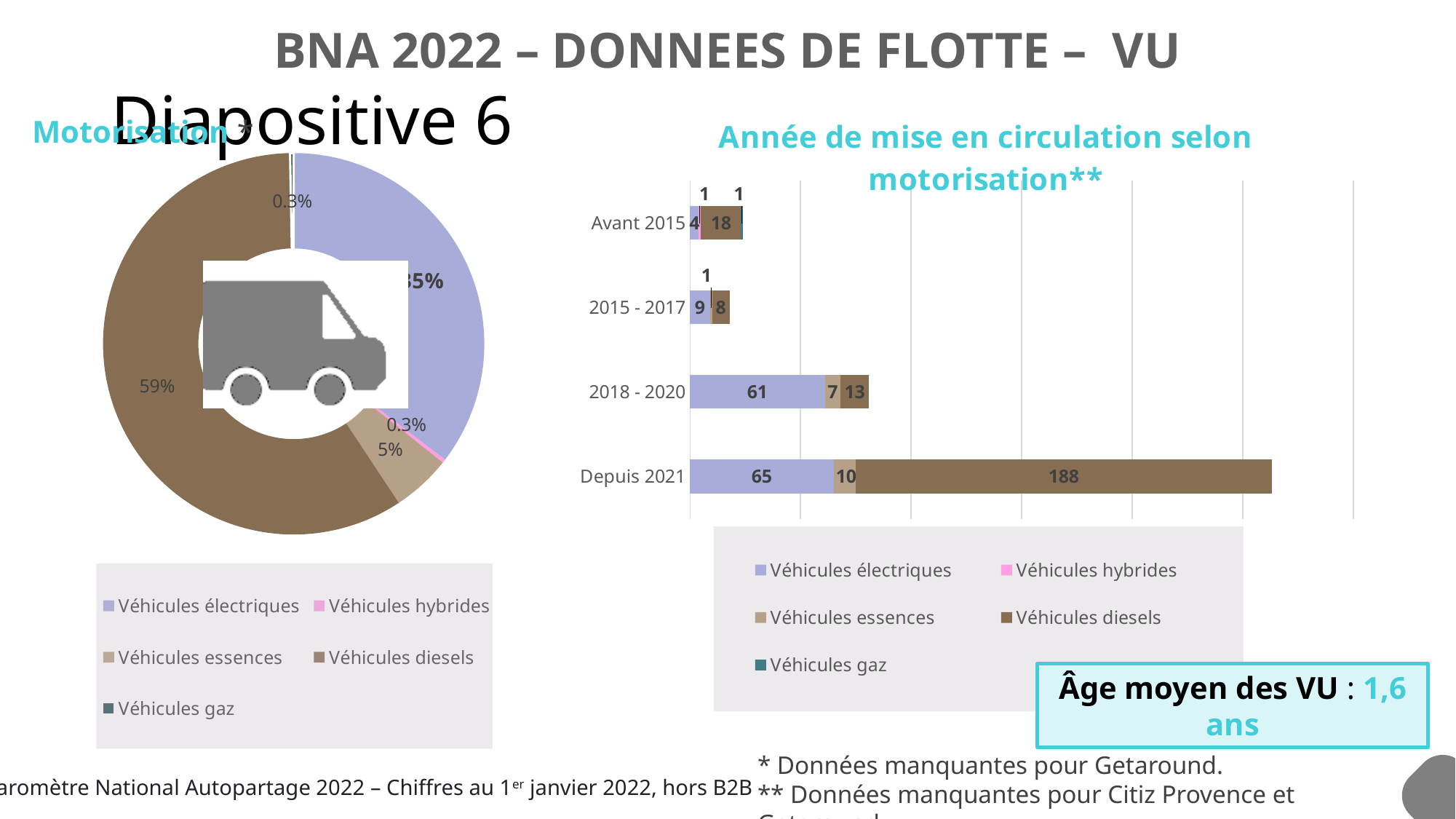
What kind of chart is the chart on the left of the slide? Doughnut chart How many categories (periods) are shown in the chart 'Année de mise en circulation selon motorisation**'? 4 In the pie chart on the left, what share of the fleet is Véhicules essences? 5% In the chart 'Année de mise en circulation selon motorisation**', what is the total of the stacked bar for 'Depuis 2021'? 263 How many series does the legend of the chart 'Année de mise en circulation selon motorisation**' list? 5 In the chart 'Année de mise en circulation selon motorisation**', what is the difference between the Véhicules diesels values for 'Depuis 2021' and '2018 - 2020'? 175 In the chart 'Année de mise en circulation selon motorisation**', which period has the longest stacked bar? Depuis 2021 In the chart 'Année de mise en circulation selon motorisation**', what is the total of the stacked bar for '2018 - 2020'? 81 In the chart 'Année de mise en circulation selon motorisation**', what is the value for Véhicules électriques in the '2018 - 2020' category? 61 In the pie chart on the left, which motorisation has the largest share? Véhicules diesels In the chart 'Année de mise en circulation selon motorisation**', what is the value for Véhicules diesels in the 'Depuis 2021' category? 188 In the pie chart on the left, what share of the fleet is Véhicules diesels? 59%